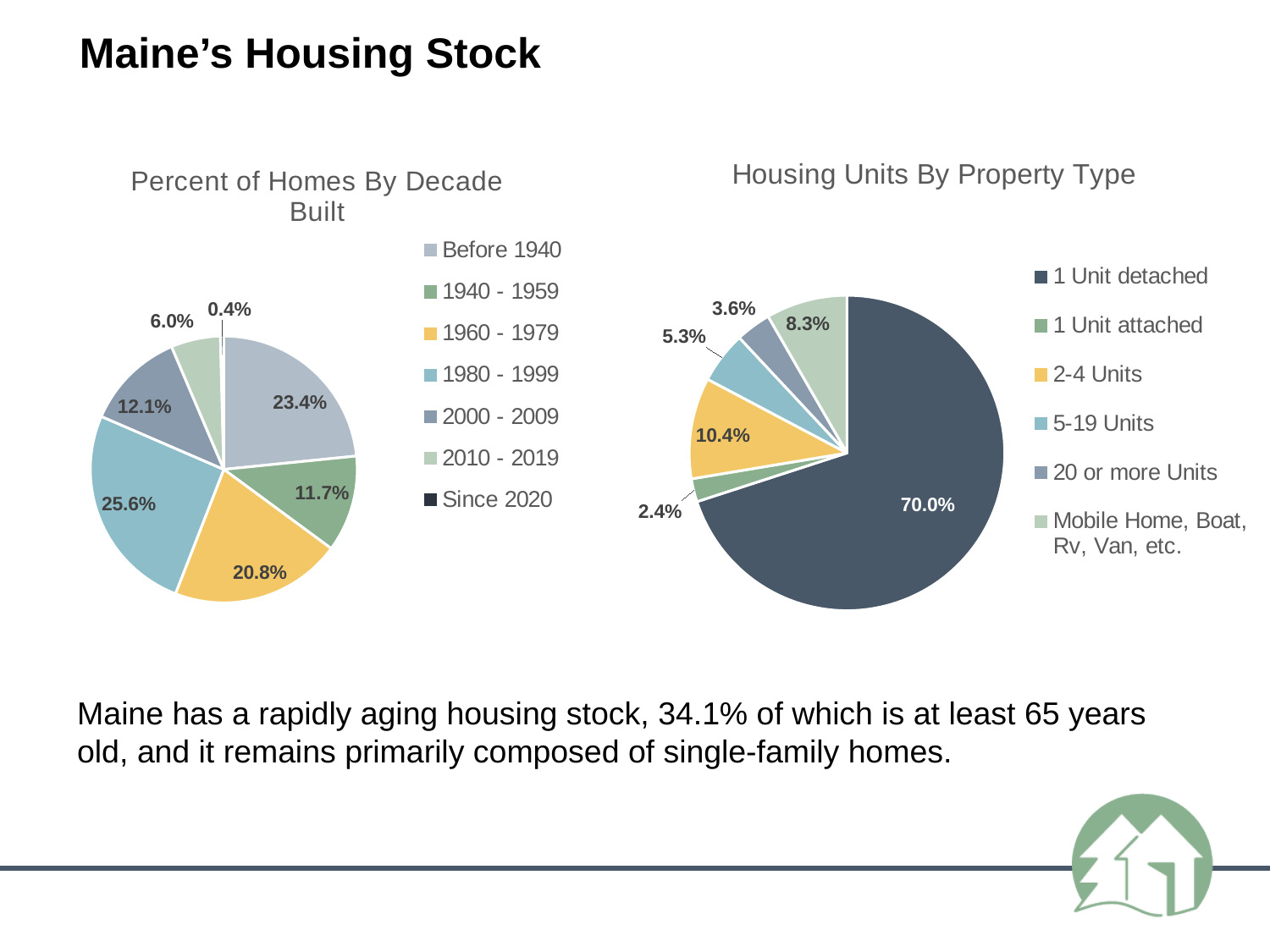
What kind of chart is the "Housing Units By Property Type" chart? Pie chart In the "Housing Units By Property Type" chart, which is larger: the share for 5-19 Units or the share for Mobile Home, Boat, Rv, Van, etc.? Mobile Home, Boat, Rv, Van, etc. In the "Housing Units By Property Type" chart, what share of housing units are 2-4 Units? 10.4% In the "Percent of Homes By Decade Built" chart, which decade category has the smallest share? Since 2020 In the "Housing Units By Property Type" chart, what share of housing units are 1 Unit detached? 70.0% In the "Percent of Homes By Decade Built" chart, what percentage of homes were built in 1980 - 1999? 25.6% In the "Percent of Homes By Decade Built" chart, which decade category has the largest share? 1980 - 1999 In the "Percent of Homes By Decade Built" chart, how many categories does the legend list? 7 In the "Percent of Homes By Decade Built" chart, what is the difference between the 1960 - 1979 share and the 1940 - 1959 share? 9.1% In the "Housing Units By Property Type" chart, what is the difference between the 20 or more Units share and the 1 Unit attached share? 1.2% In the "Housing Units By Property Type" chart, which property type has the smallest share? 1 Unit attached In the "Percent of Homes By Decade Built" chart, what percentage of homes were built before 1940? 23.4%